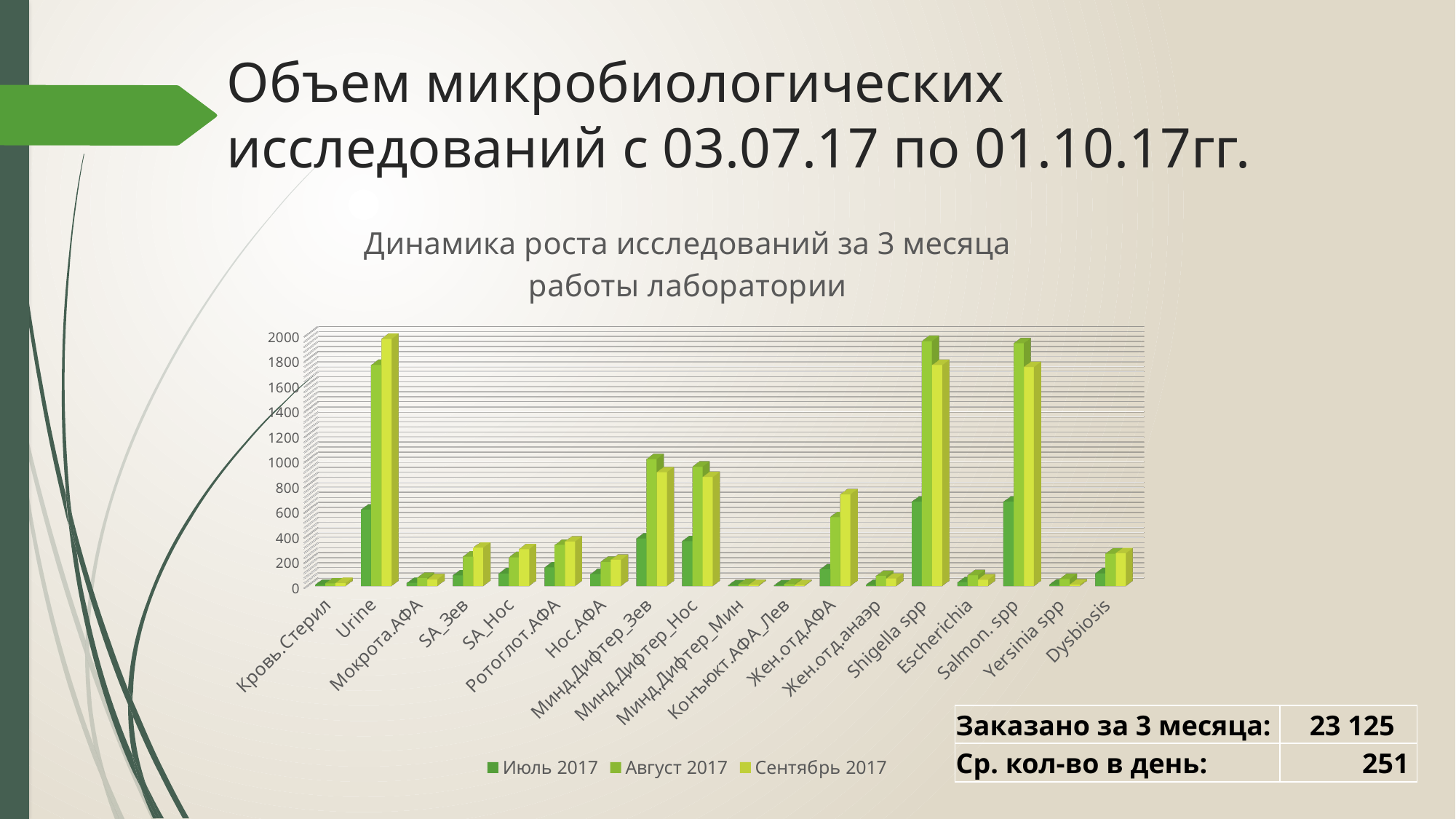
What is the title of the chart? Динамика роста исследований за 3 месяца работы лаборатории What kind of chart is shown on the slide? bar chart Is the value for Urine in Июль 2017 greater or less than 400? greater Is the value for Dysbiosis in Сентябрь 2017 greater or less than 400? less Is the value for Shigella spp in Август 2017 greater or less than 1800? greater How many categories are shown on the x axis of the chart? 18 Which category has the highest value for Сентябрь 2017? Urine Do the values for Urine rise or fall from Июль 2017 to Сентябрь 2017? rise Which series are listed in the chart legend? Июль 2017, Август 2017, Сентябрь 2017 How many series does the chart legend list? 3